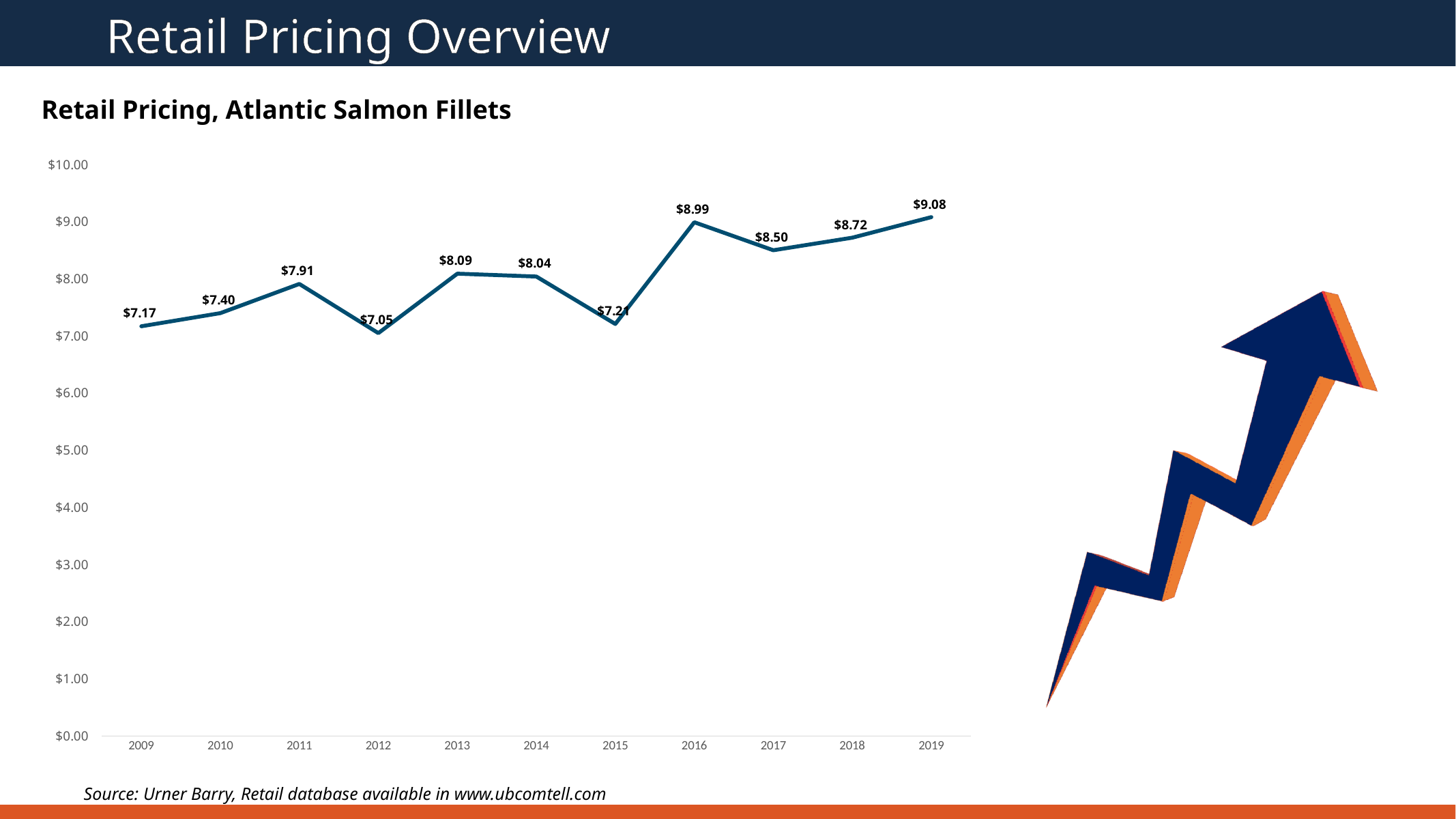
What kind of chart is used to show retail pricing of Atlantic salmon fillets? line chart Is the retail price for 2017 greater or less than $8.00? greater What was the retail price of Atlantic salmon fillets in 2019? $9.08 What is the title of the chart on the slide? Retail Pricing, Atlantic Salmon Fillets Which year had a higher retail price, 2013 or 2014? 2013 How many years are shown on the x axis of the chart? 11 What is the difference between the retail price in 2019 and the retail price in 2009? $1.91 Which year had the lowest retail price for Atlantic salmon fillets? 2012 Did the retail price of Atlantic salmon fillets rise or fall between 2015 and 2016? rise What was the retail price of Atlantic salmon fillets in 2016? $8.99 Which year had the highest retail price for Atlantic salmon fillets? 2019 What was the retail price of Atlantic salmon fillets in 2012? $7.05